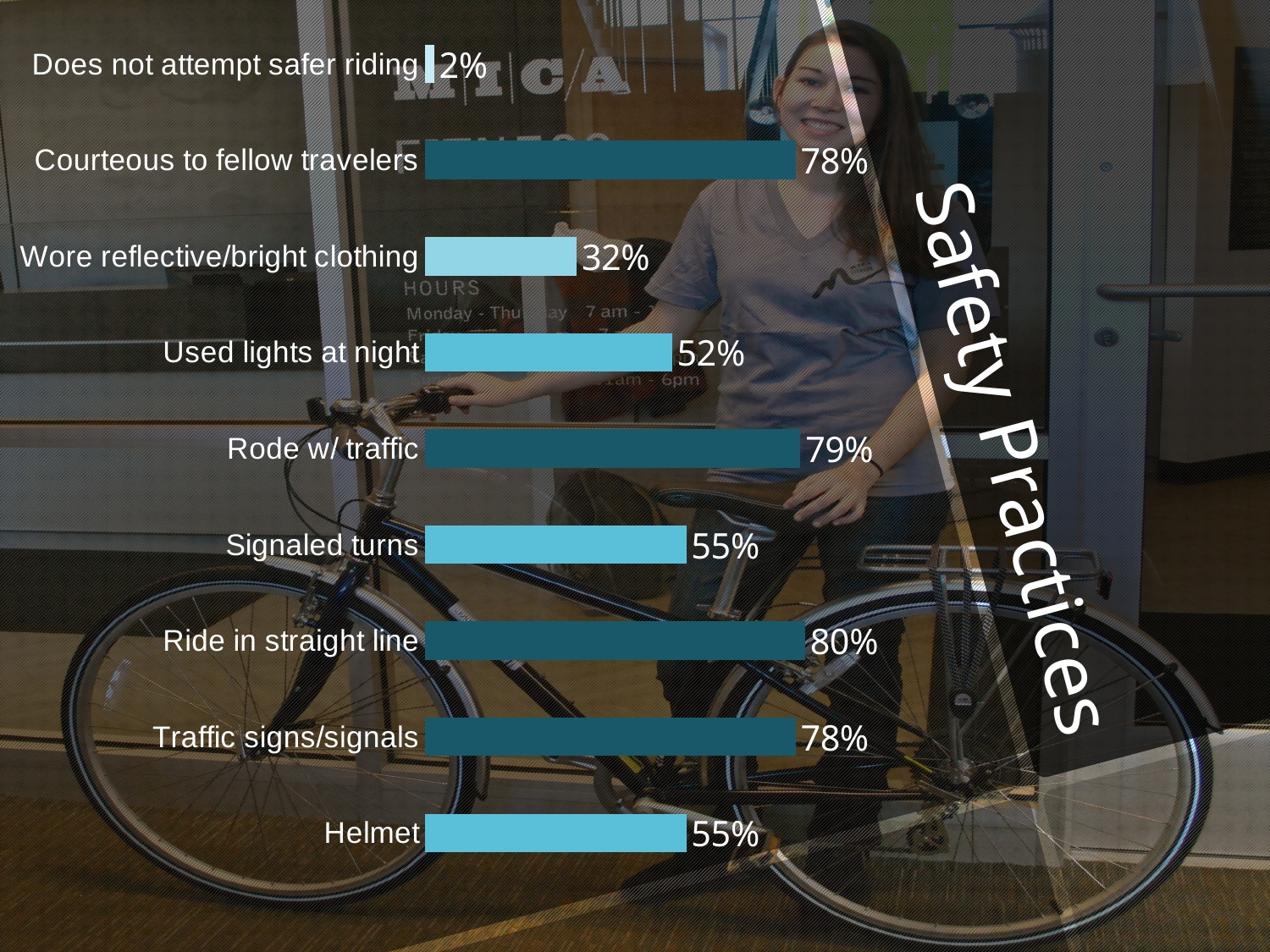
What percentage is shown for Used lights at night? 52% What percentage is shown for Courteous to fellow travelers? 78% What is the difference between the percentages for Rode w/ traffic and Wore reflective/bright clothing? 47% What percentage is shown for Wore reflective/bright clothing? 32% Which safety practice has the highest percentage? Ride in straight line What kind of chart is shown on the slide? Bar chart What is the title of the chart? Safety Practices What percentage is shown for Helmet? 55% Which is larger, the value for Signaled turns or the value for Used lights at night? Signaled turns Which category has the lowest percentage? Does not attempt safer riding What is the difference between the percentages for Ride in straight line and Traffic signs/signals? 2% How many categories are shown in the chart? 9